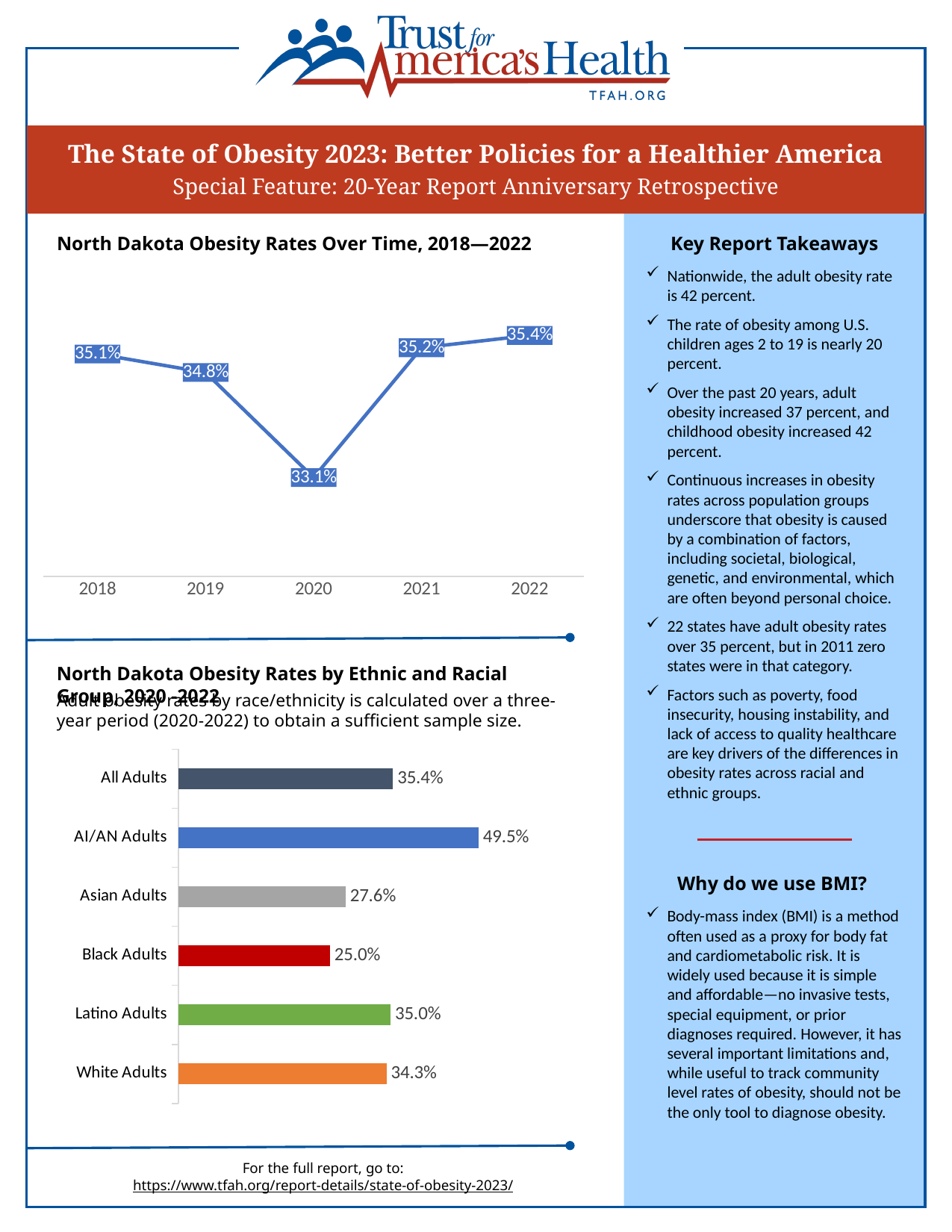
In the 'North Dakota Obesity Rates by Ethnic and Racial Group, 2020–2022' chart, what is the obesity rate for AI/AN Adults? 49.5% What kind of chart is 'North Dakota Obesity Rates Over Time, 2018—2022'? Line chart In the 'North Dakota Obesity Rates Over Time, 2018—2022' chart, how many years are plotted? 5 In the 'North Dakota Obesity Rates by Ethnic and Racial Group, 2020–2022' chart, which group has the lowest obesity rate? Black Adults In the 'North Dakota Obesity Rates Over Time, 2018—2022' chart, which year has the lowest obesity rate? 2020 What kind of chart is 'North Dakota Obesity Rates by Ethnic and Racial Group, 2020–2022'? Bar chart In the 'North Dakota Obesity Rates by Ethnic and Racial Group, 2020–2022' chart, what is the difference between the AI/AN Adults and Asian Adults values? 21.9 percentage points In the 'North Dakota Obesity Rates Over Time, 2018—2022' chart, which year has the highest obesity rate? 2022 In the 'North Dakota Obesity Rates Over Time, 2018—2022' chart, does the obesity rate rise or fall from 2020 to 2022? Rise In the 'North Dakota Obesity Rates Over Time, 2018—2022' chart, what is the obesity rate for 2020? 33.1% In the 'North Dakota Obesity Rates Over Time, 2018—2022' chart, what is the difference between the 2022 and 2020 values? 2.3 percentage points In the 'North Dakota Obesity Rates by Ethnic and Racial Group, 2020–2022' chart, which is larger: the value for Latino Adults or White Adults? Latino Adults